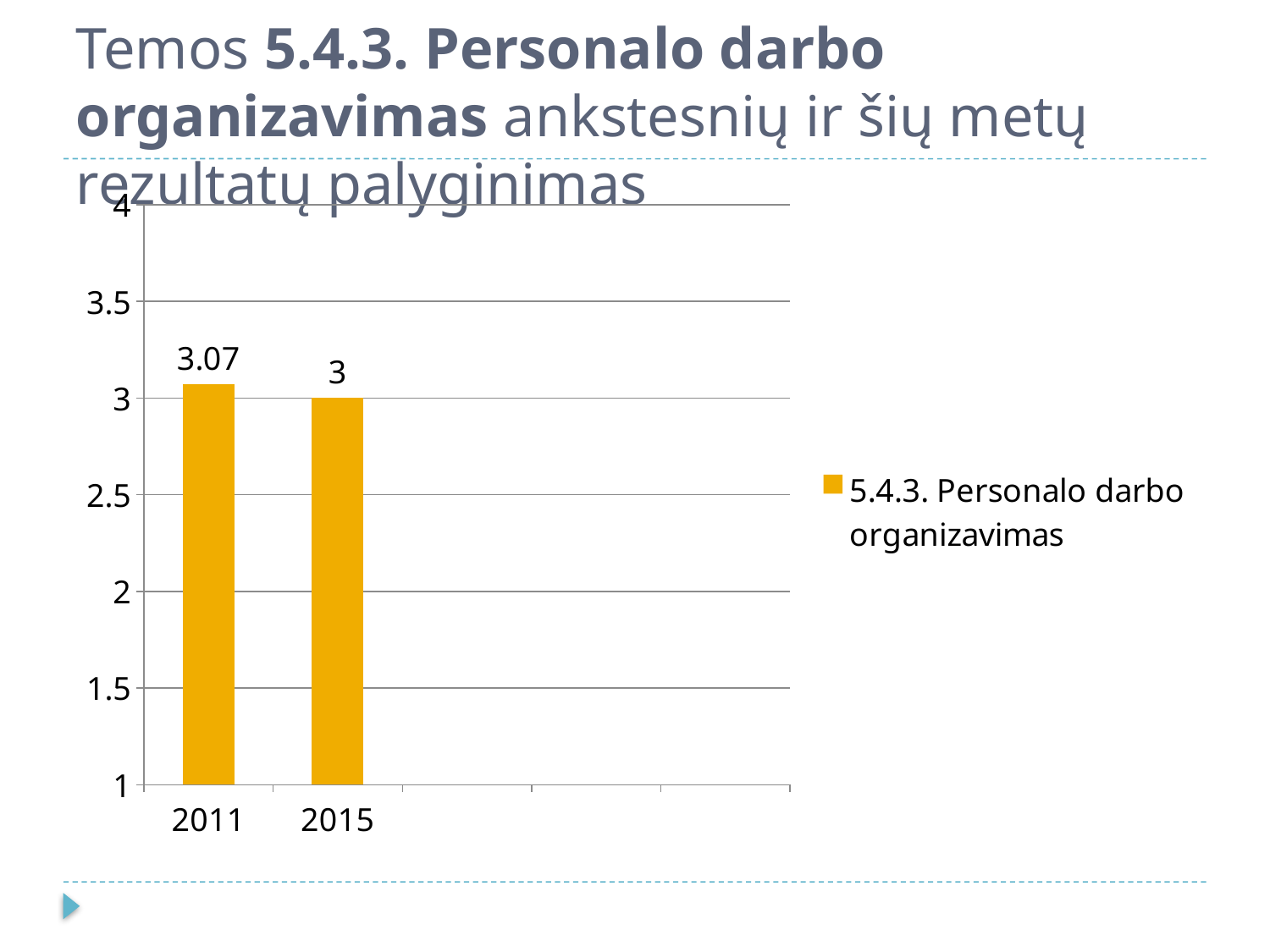
Which year has the lower value? 2015 How many series does the legend list? 1 How many categories are shown on the x axis? 2 Do the values rise or fall from 2011 to 2015? fall Is the value for 2015 greater or less than 3.5? less Which year has the higher value? 2011 What kind of chart is shown on the slide? bar chart What is the difference between the 2011 value and the 2015 value? 0.07 What is the value for 2011? 3.07 What is the value for 2015? 3 Is the value for 2011 larger or smaller than the value for 2015? larger What is the legend entry for the series? 5.4.3. Personalo darbo organizavimas